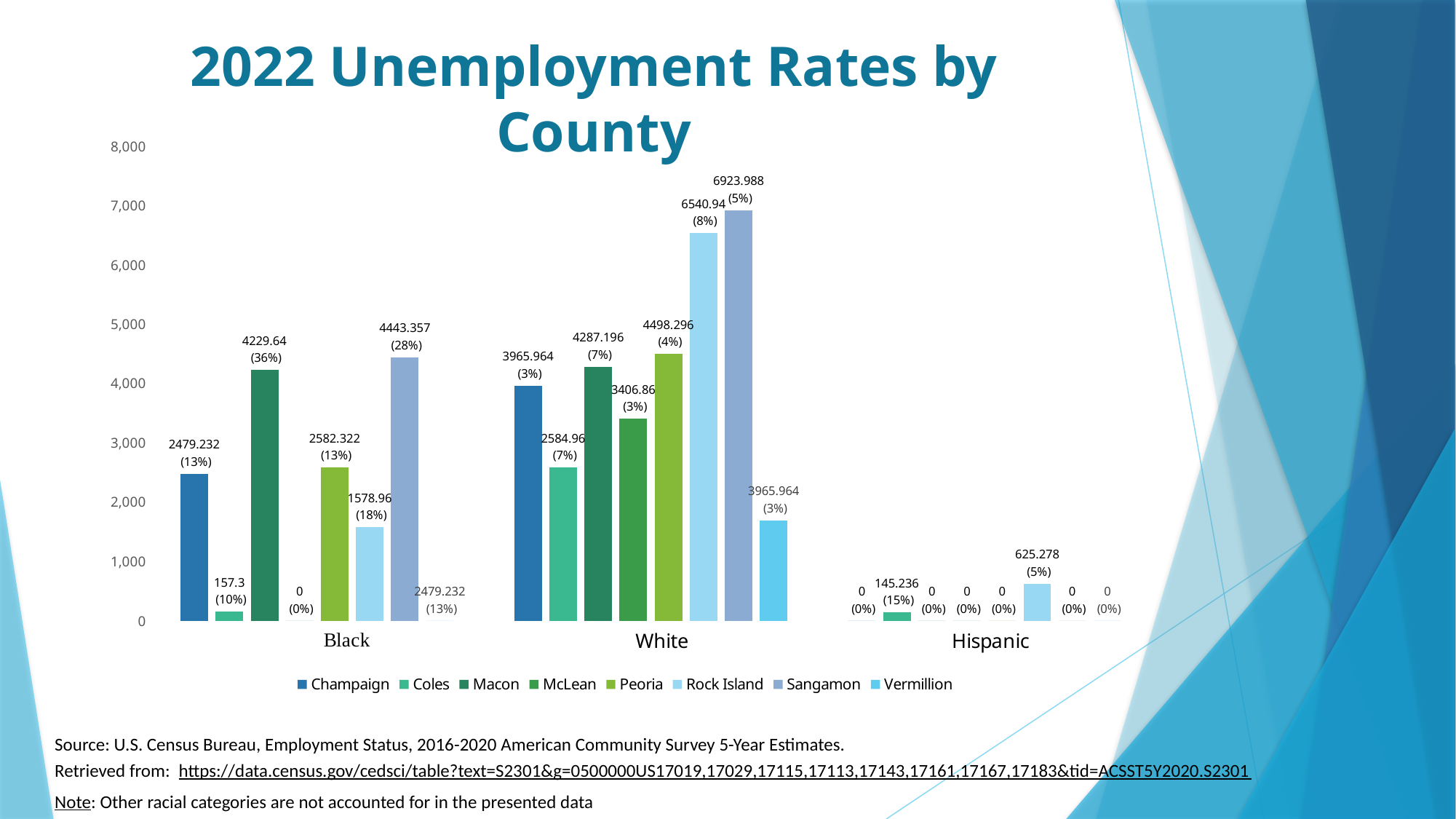
What is the value for Macon in the Black category? 4229.64 What is the difference between the Rock Island and Champaign values in the White category? 2574.976 What is the value for Sangamon in the White category? 6923.988 In the White category, which is larger: the value for Peoria or the value for Macon? Peoria How many racial categories are shown on the x axis? 3 How many series does the legend list? 8 Which county has the highest value in the Hispanic category? Rock Island Which county has the highest value in the White category? Sangamon What percentage is shown for Macon in the Black category? 36% What kind of chart is shown on the slide? bar chart Is the value for Rock Island in the Black category greater or less than 2,000? less What is the value for Coles in the Hispanic category? 145.236